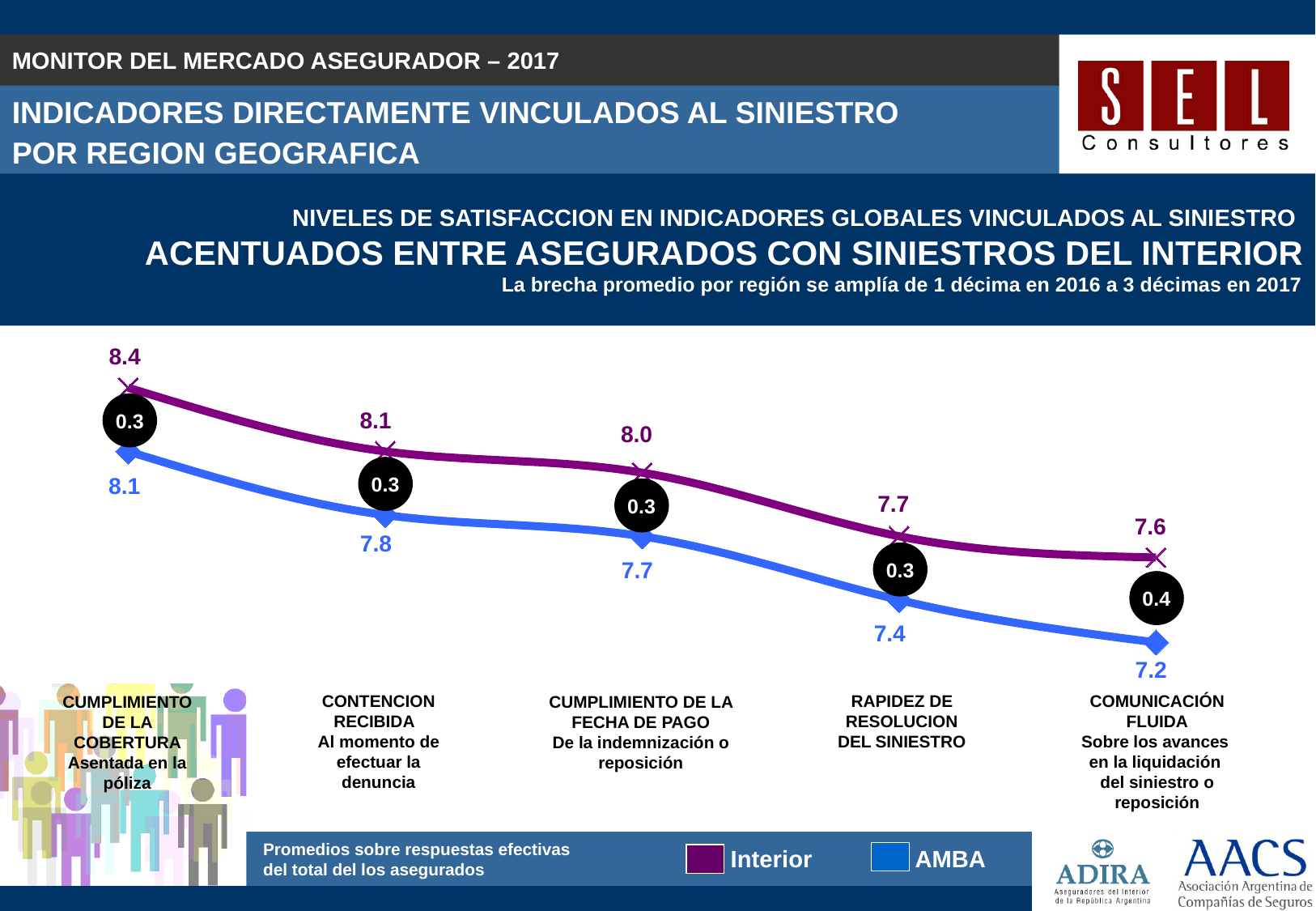
What is the AMBA value for RAPIDEZ DE RESOLUCION DEL SINIESTRO? 7.4 What is the Interior value for CUMPLIMIENTO DE LA FECHA DE PAGO? 8.0 Which is larger for RAPIDEZ DE RESOLUCION DEL SINIESTRO, the Interior value or the AMBA value? Interior How many series does the legend list? 2 What is the difference between the Interior and AMBA values for COMUNICACIÓN FLUIDA? 0.4 What is the difference between the Interior and AMBA values for CONTENCION RECIBIDA? 0.3 What is the Interior value for CUMPLIMIENTO DE LA COBERTURA? 8.4 Which category has the highest Interior value? CUMPLIMIENTO DE LA COBERTURA How many categories are shown on the chart? 5 What is the AMBA value for COMUNICACIÓN FLUIDA? 7.2 Which category has the lowest AMBA value? COMUNICACIÓN FLUIDA Do the Interior values rise or fall from left to right across the categories? fall